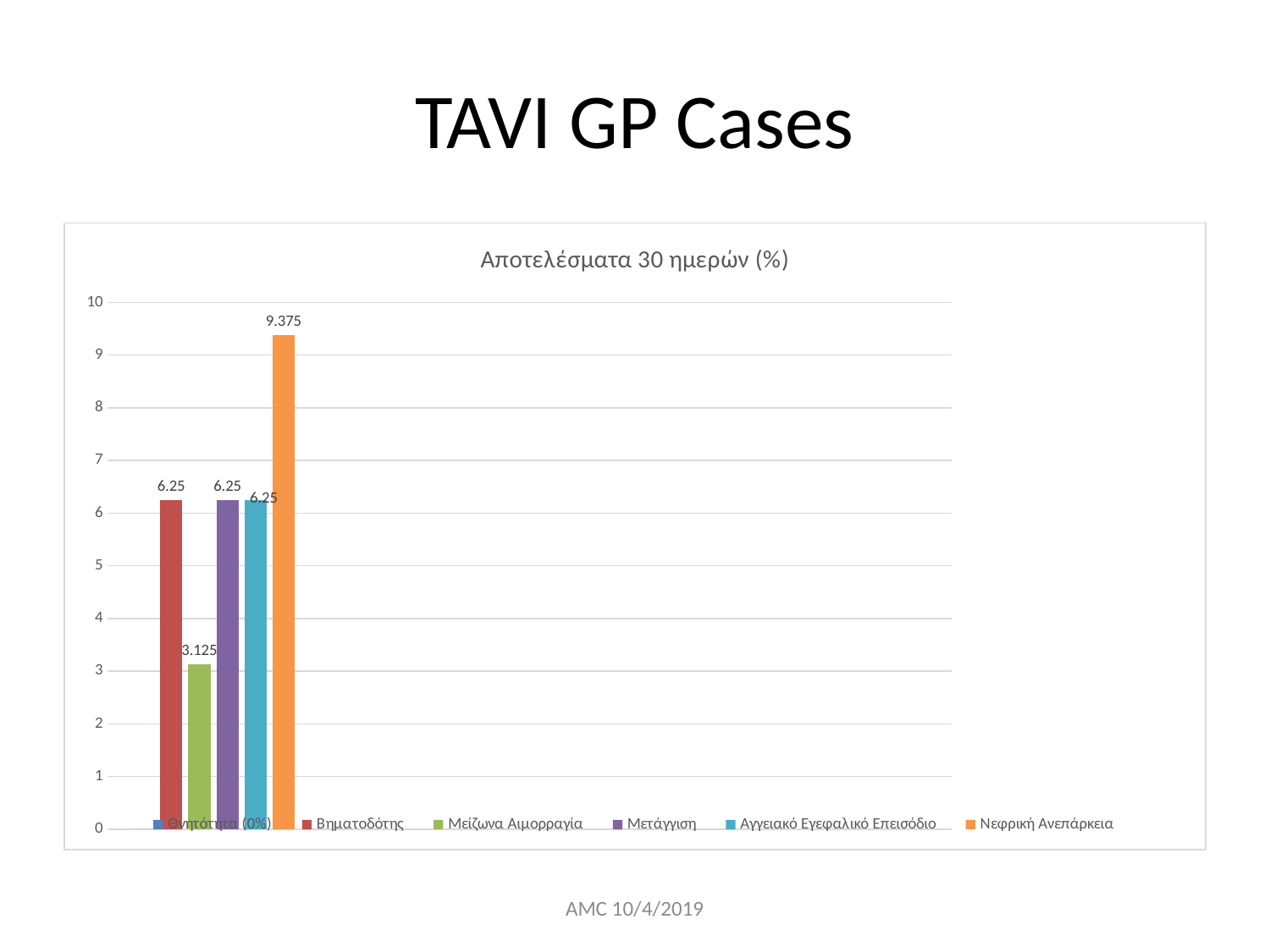
What is the title of the chart? Αποτελέσματα 30 ημερών (%) What is the value for Μείζωνα Αιμορραγία? 3.125 What is the difference between the values for Νεφρική Ανεπάρκεια and Αγγειακό Εγεφαλικό Επεισόδιο? 3.125 Which is larger, the value for Βηματοδότης or the value for Μείζωνα Αιμορραγία? Βηματοδότης Is the value for Νεφρική Ανεπάρκεια greater or less than 9? greater What is the value for Νεφρική Ανεπάρκεια? 9.375 What kind of chart is shown on the slide? bar chart What is the value for Βηματοδότης? 6.25 Which category has the lowest non-zero value? Μείζωνα Αιμορραγία What is the value for Μετάγγιση? 6.25 How many series does the legend list? 6 Which category has the highest value? Νεφρική Ανεπάρκεια